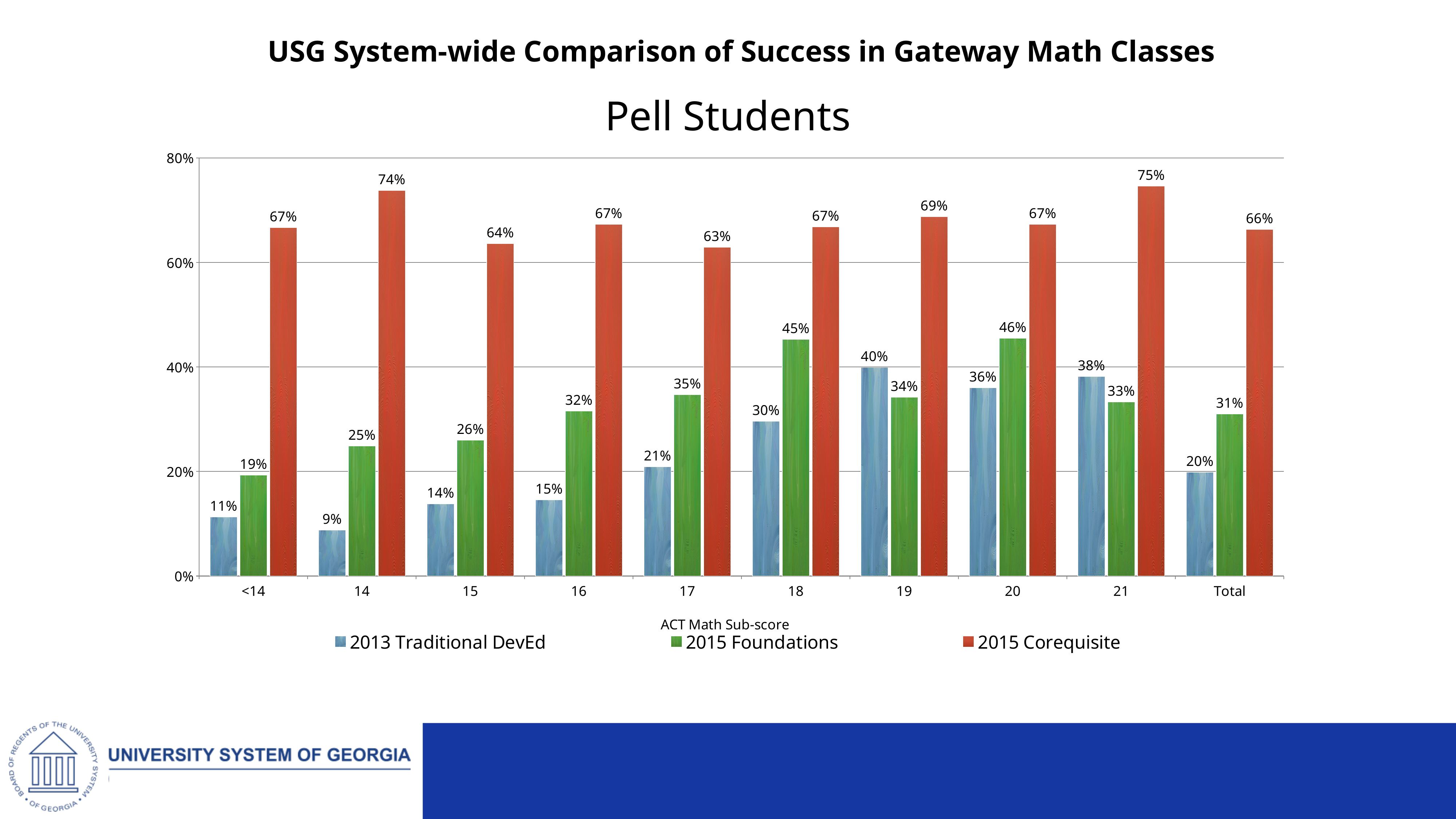
Which ACT Math Sub-score category has the highest 2015 Corequisite value? 21 Which is larger for ACT Math Sub-score 19: 2013 Traditional DevEd or 2015 Foundations? 2013 Traditional DevEd Which ACT Math Sub-score category has the lowest 2013 Traditional DevEd value? 14 What is the 2015 Foundations value for ACT Math Sub-score 18? 45% What is the 2013 Traditional DevEd value for the Total category? 20% What is the difference between the 2015 Corequisite and 2015 Foundations values for the Total category? 35% What is the 2015 Corequisite value for ACT Math Sub-score 14? 74% How many categories are shown on the x axis? 10 What kind of chart is shown on the slide? Bar chart Do the 2013 Traditional DevEd values generally rise or fall from <14 to 21 along the x axis? Rise How many series does the legend list? 3 What is the x-axis title of the chart? ACT Math Sub-score